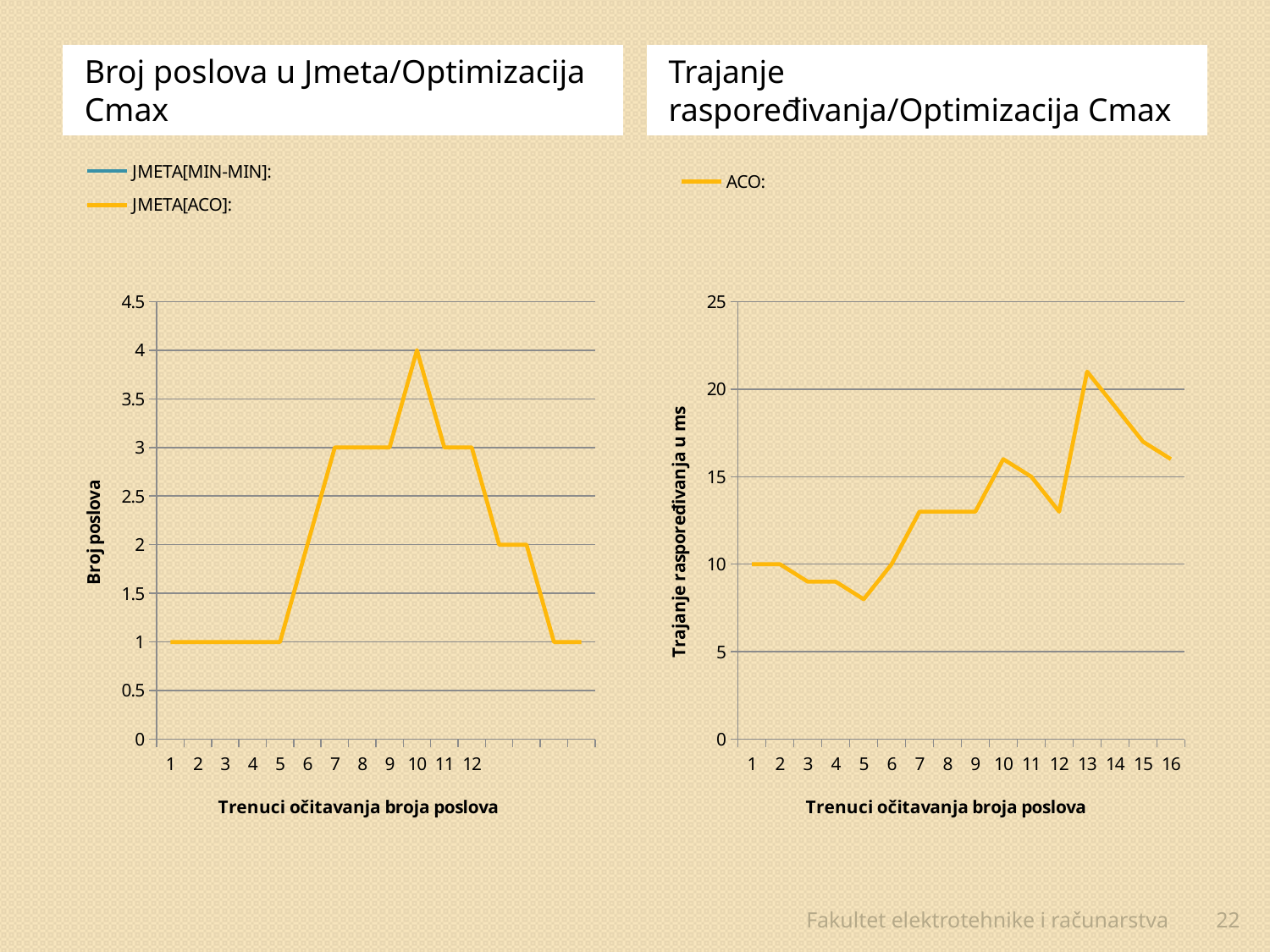
How many series does the legend of the left chart 'Broj poslova u Jmeta/Optimizacija Cmax' list? 2 In the right chart 'Trajanje raspoređivanja/Optimizacija Cmax', is the ACO value at point 13 greater or less than 20? greater In the right chart 'Trajanje raspoređivanja/Optimizacija Cmax', at which x-axis point is the ACO value lowest? 5 In the left chart 'Broj poslova u Jmeta/Optimizacija Cmax', what is the value of the JMETA[ACO] line at point 7? 3 In the left chart 'Broj poslova u Jmeta/Optimizacija Cmax', what is the value of the JMETA[ACO] line at point 10? 4 In the right chart 'Trajanje raspoređivanja/Optimizacija Cmax', what is the ACO value at point 1? 10 What kind of chart is the 'Broj poslova u Jmeta/Optimizacija Cmax' chart on the left? Line chart How many points are plotted along the x axis of the right chart 'Trajanje raspoređivanja/Optimizacija Cmax'? 16 What is the y-axis title of the right chart 'Trajanje raspoređivanja/Optimizacija Cmax'? Trajanje raspoređivanja u ms In the right chart 'Trajanje raspoređivanja/Optimizacija Cmax', at which x-axis point is the ACO value highest? 13 How many series does the legend of the right chart 'Trajanje raspoređivanja/Optimizacija Cmax' list? 1 In the left chart 'Broj poslova u Jmeta/Optimizacija Cmax', at which x-axis point does the JMETA[ACO] line reach its highest value? 10